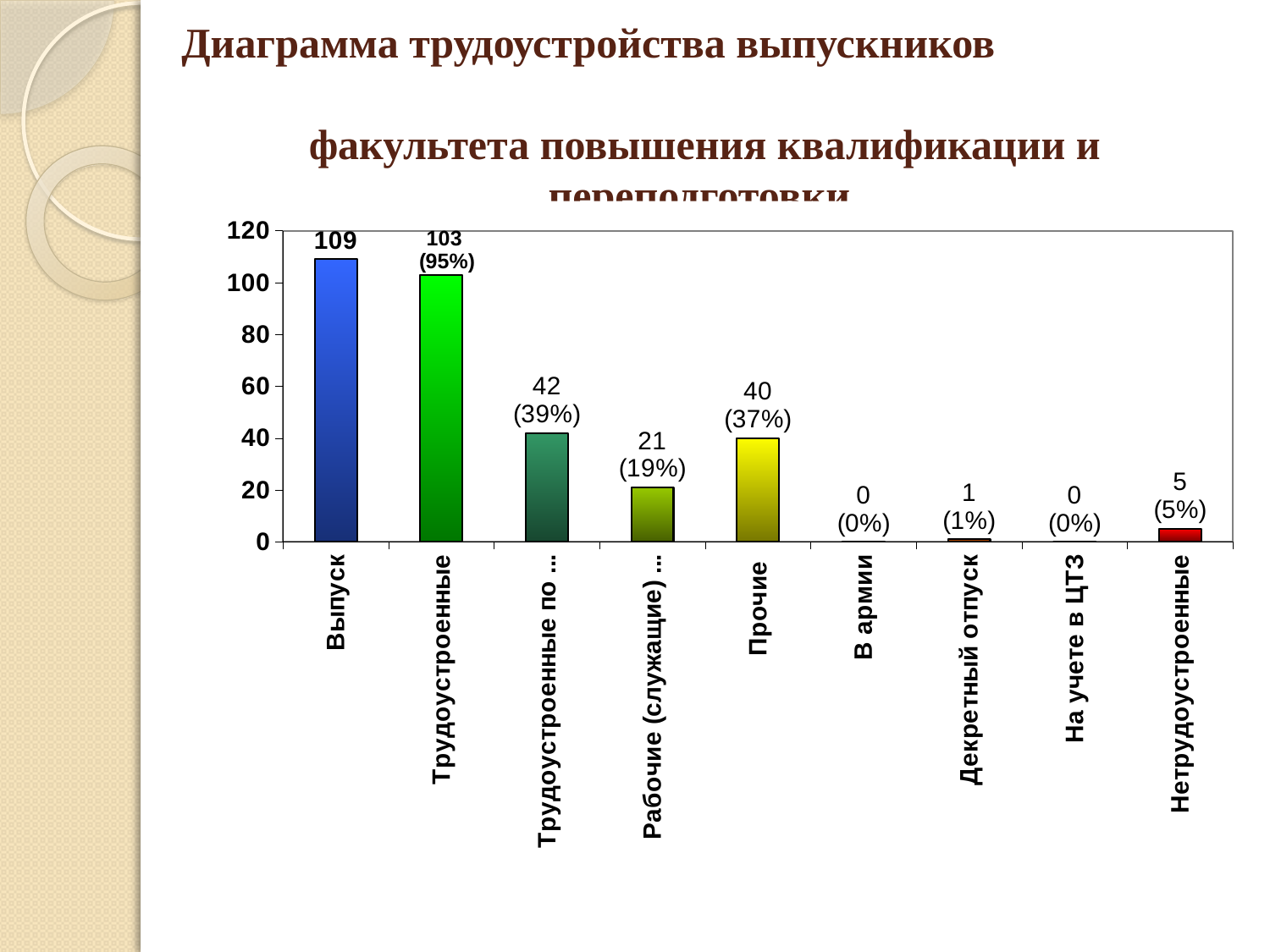
Which is larger, the value for Прочие or the value for Нетрудоустроенные? Прочие Which category has the highest value? Выпуск How many categories are shown on the x axis? 9 What value is shown for В армии? 0 What is the value for Нетрудоустроенные? 5 What kind of chart is shown on the slide? Bar chart What is the difference between the values for Выпуск and Трудоустроенные? 6 What is the value for Декретный отпуск? 1 What is the value for Выпуск? 109 What is the value for Трудоустроенные? 103 What is the value for Прочие? 40 What percentage is shown for Трудоустроенные? 95%